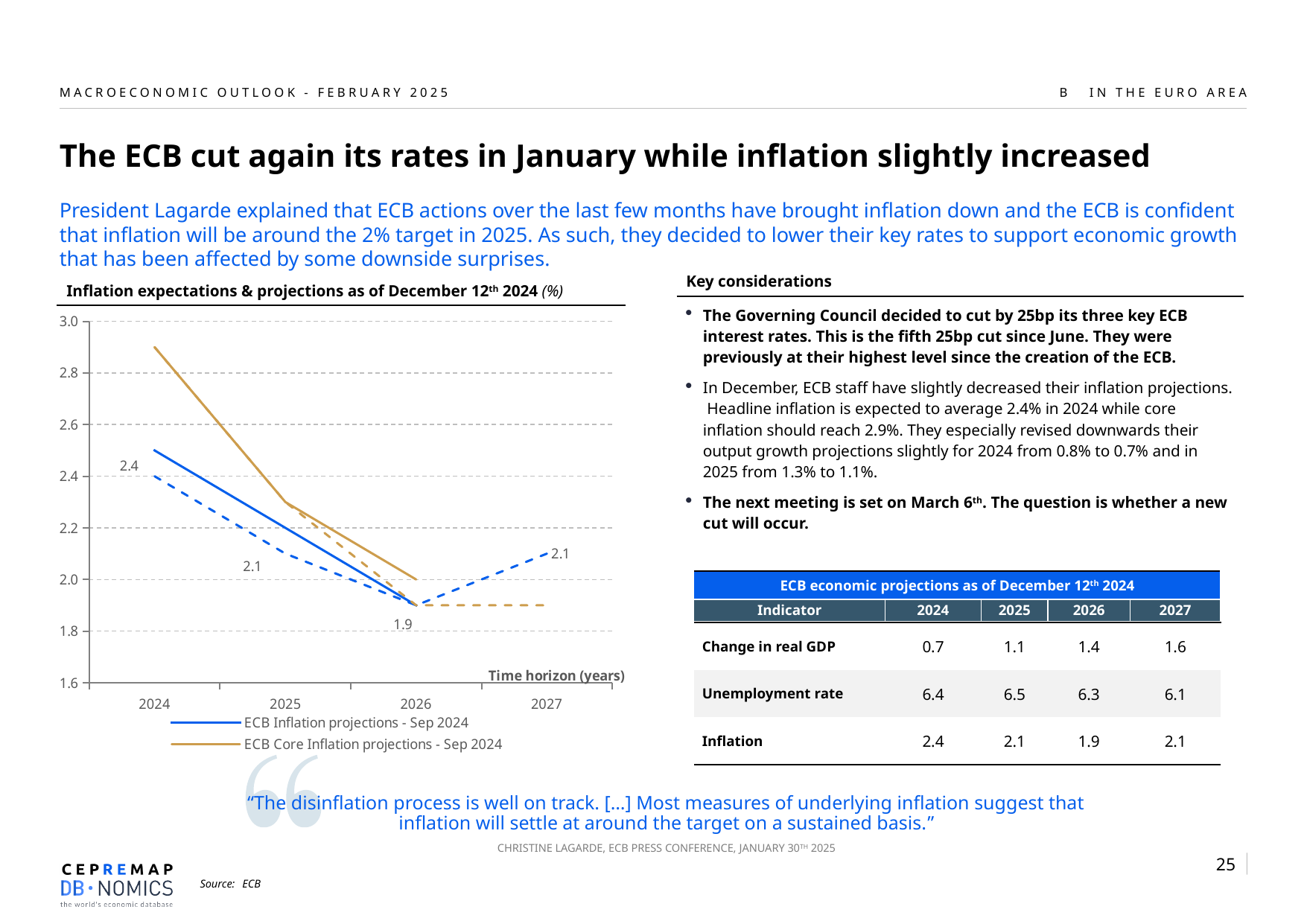
What kind of chart is shown on the slide? line chart What is the difference between the labelled values for 2024 (2.4) and 2026 (1.9) on the dashed inflation projection line? 0.5 Does the ECB Inflation projections - Sep 2024 line rise or fall from 2024 to 2026? fall How many years are shown on the x axis of the chart? 4 Is the value of the ECB Core Inflation projections - Sep 2024 line at 2024 greater or less than 2.8? greater At 2024, which line is higher: ECB Inflation projections - Sep 2024 or ECB Core Inflation projections - Sep 2024? ECB Core Inflation projections - Sep 2024 Is the value of the ECB Inflation projections - Sep 2024 line at 2024 greater or less than 2.4? greater How many series does the chart legend list? 2 What is the data label shown at 2026 on the dashed inflation projection line? 1.9 What is the title of the x axis of the chart? Time horizon (years) What is the data label shown at 2024 on the dashed inflation projection line? 2.4 Which year has the lowest labelled value on the dashed inflation projection line? 2026